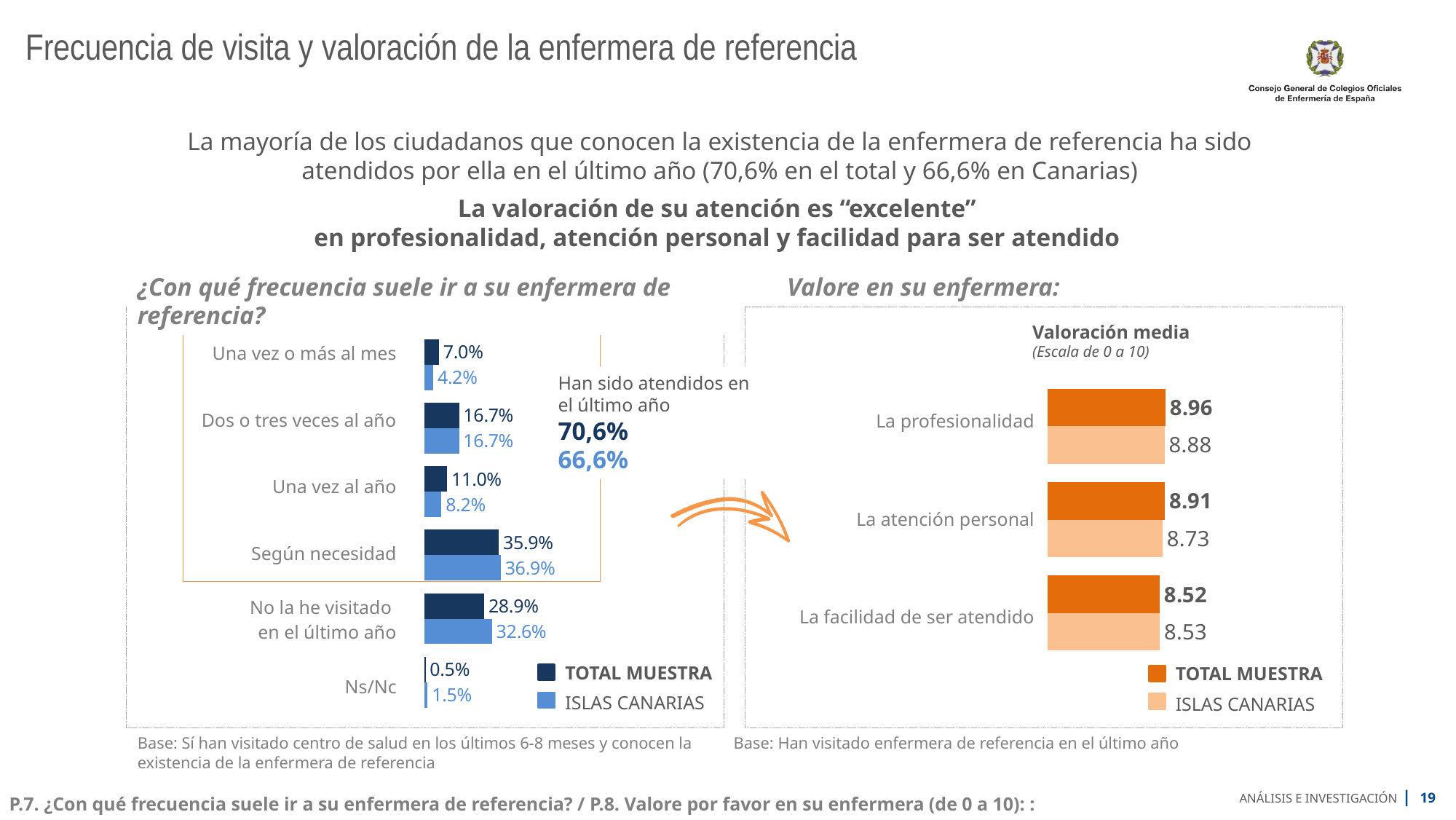
In the right chart (Valore en su enfermera), what is the ISLAS CANARIAS score for 'La facilidad de ser atendido'? 8.53 In the left chart (¿Con qué frecuencia suele ir a su enfermera de referencia?), which category has the highest TOTAL MUESTRA value? Según necesidad In the right chart (Valore en su enfermera), which item has the highest TOTAL MUESTRA score? La profesionalidad In the right chart (Valore en su enfermera), what is the difference between the TOTAL MUESTRA and ISLAS CANARIAS scores for 'La atención personal'? 0.18 In the right chart (Valore en su enfermera), what is the TOTAL MUESTRA score for 'La atención personal'? 8.91 In the left chart (¿Con qué frecuencia suele ir a su enfermera de referencia?), how many categories are shown? 6 In the left chart (¿Con qué frecuencia suele ir a su enfermera de referencia?), what is the ISLAS CANARIAS value for 'No la he visitado en el último año'? 32.6% In the left chart (¿Con qué frecuencia suele ir a su enfermera de referencia?), how many series does the legend list? 2 In the left chart (¿Con qué frecuencia suele ir a su enfermera de referencia?), what is the TOTAL MUESTRA value for 'Según necesidad'? 35.9% What type of chart is the right chart (Valore en su enfermera)? Bar chart In the left chart (¿Con qué frecuencia suele ir a su enfermera de referencia?), which category has the lowest ISLAS CANARIAS value? Ns/Nc In the left chart (¿Con qué frecuencia suele ir a su enfermera de referencia?), what is the difference between the TOTAL MUESTRA and ISLAS CANARIAS values for 'Una vez o más al mes'? 2.8%